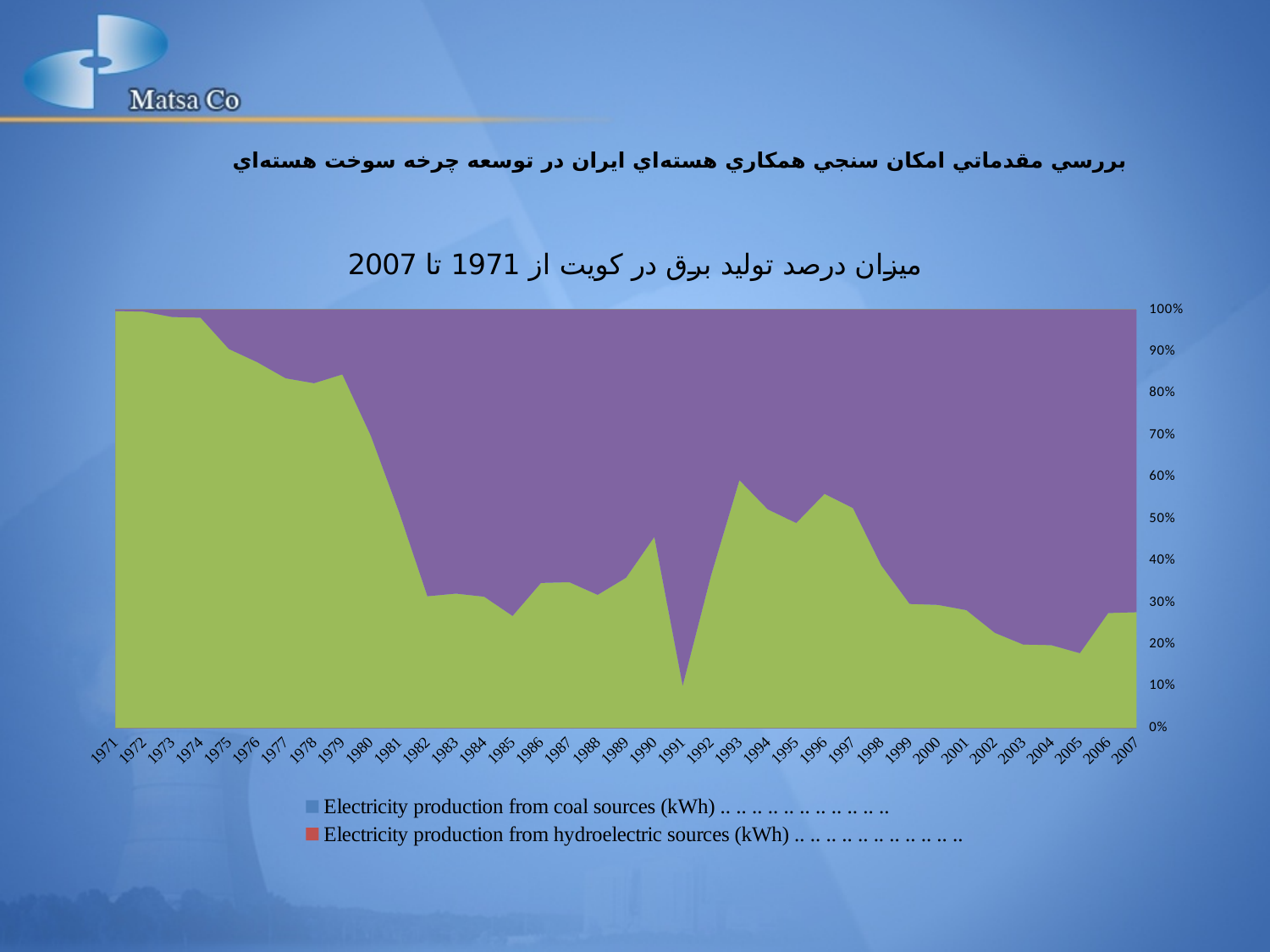
What kind of chart is shown on the slide? Stacked area chart Is the share of the lower (green) area in 1991 greater or less than 20%? less How many years are plotted along the x axis of the chart? 37 Does the share of the lower (green) area rise or fall from 1993 to 2005? fall Is the share of the lower (green) area in 1979 greater or less than 80%? greater What is the first year shown on the x axis? 1971 Does the share of the lower (green) area rise or fall from 1971 to 1982? fall Is the share of the lower (green) area in 1985 greater or less than 40%? less What is the last year shown on the x axis? 2007 How many series does the legend list? 2